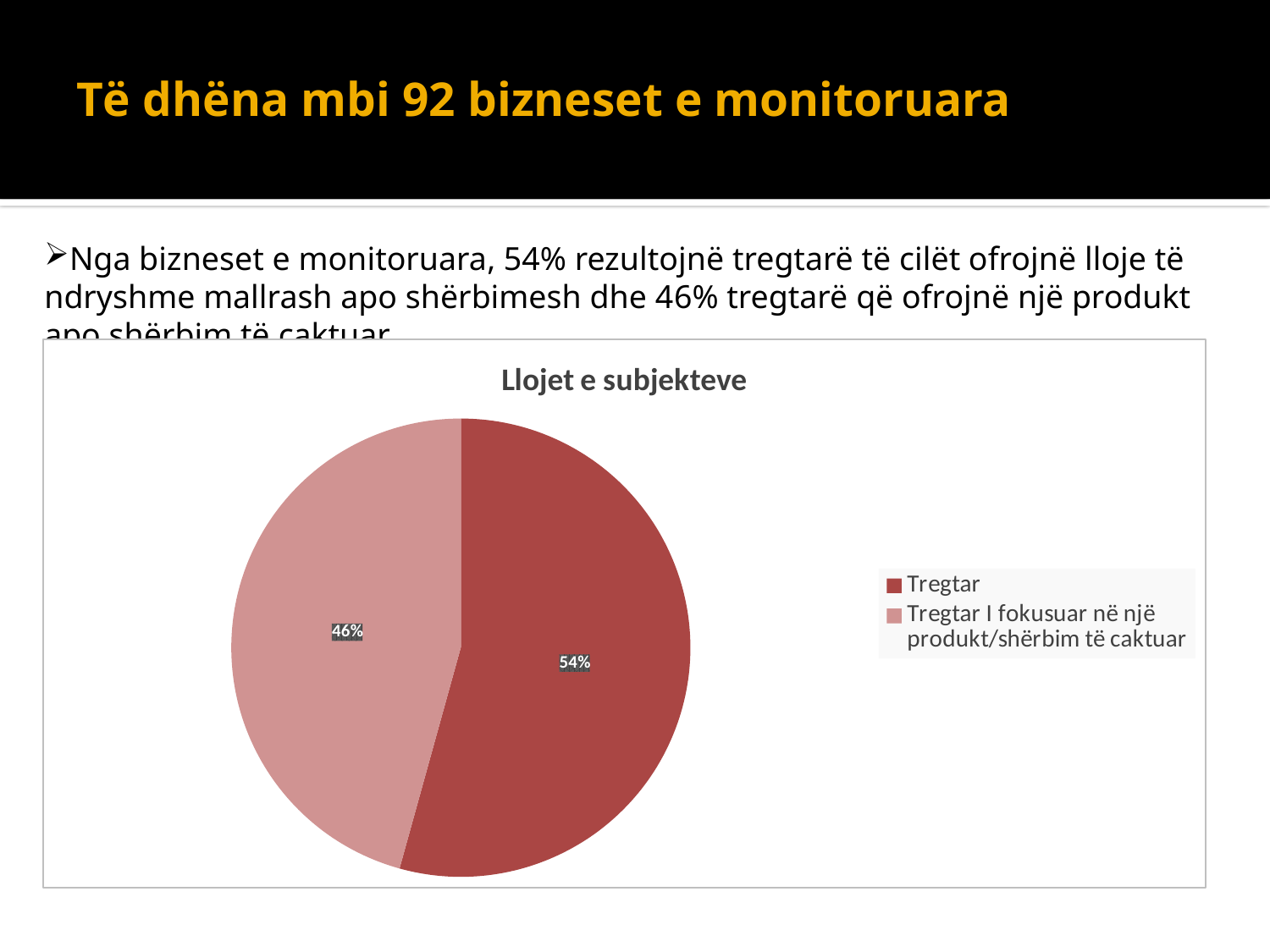
What share of the pie does the 'Tregtar' slice represent? 54% Which category has the smallest slice of the pie? Tregtar I fokusuar në një produkt/shërbim të caktuar Is the 'Tregtar' slice greater or less than 50% of the pie? greater Which is larger: the 'Tregtar' slice or the 'Tregtar I fokusuar në një produkt/shërbim të caktuar' slice? Tregtar What is the title of the chart? Llojet e subjekteve What is the difference in percentage points between the 'Tregtar' slice and the 'Tregtar I fokusuar në një produkt/shërbim të caktuar' slice? 8 percentage points How many entries does the legend list? 2 How many slices does the pie chart have? 2 Which legend entry is shown in the lighter pink colour? Tregtar I fokusuar në një produkt/shërbim të caktuar Which category has the largest slice of the pie? Tregtar What share of the pie does the 'Tregtar I fokusuar në një produkt/shërbim të caktuar' slice represent? 46% What kind of chart is shown on the slide? pie chart